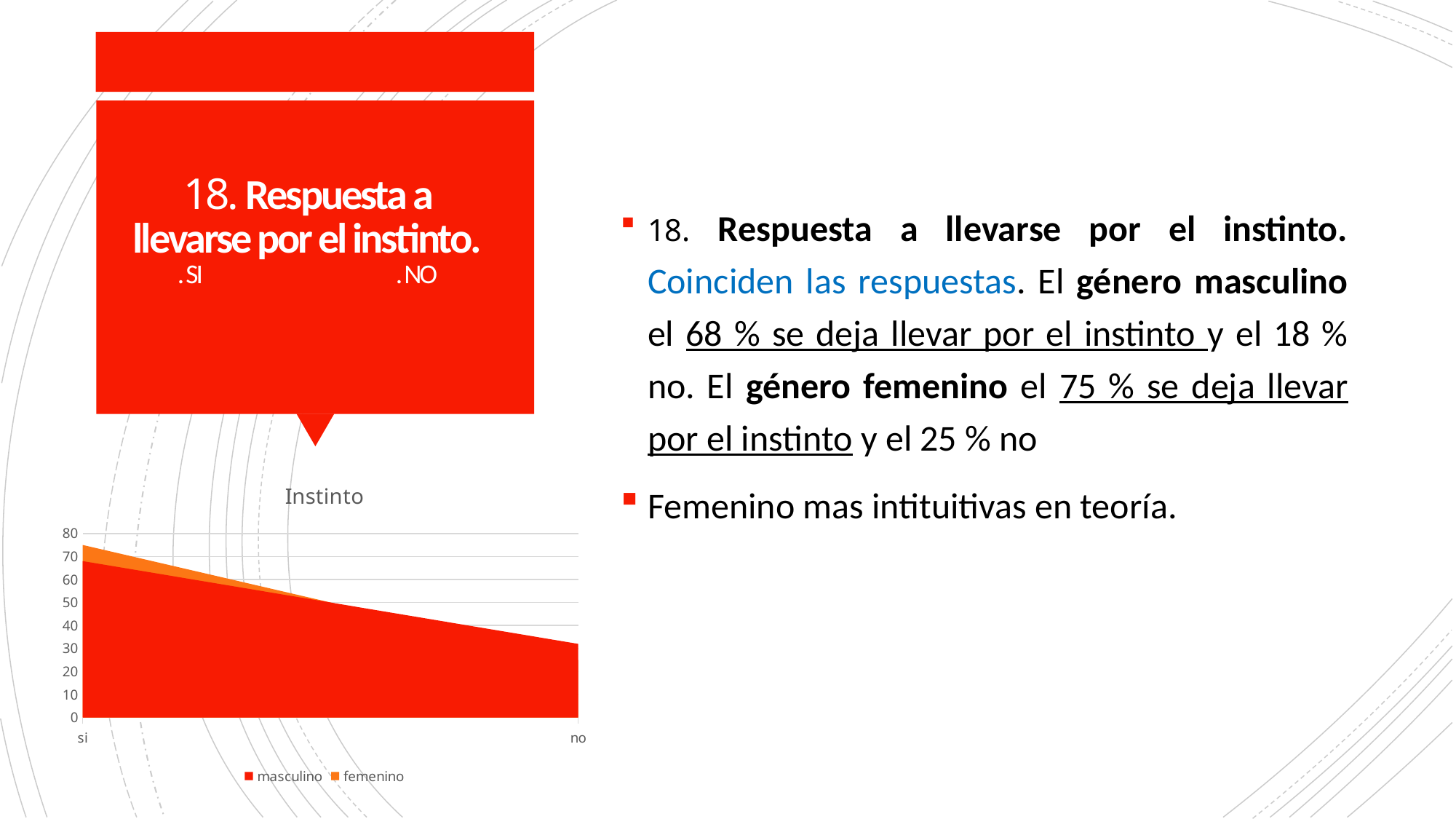
For the femenino series, which category has the lowest value? no Is the value for femenino at 'si' greater or less than 70? greater Is the value for masculino at 'si' greater or less than 60? greater For the masculino series, which category has the highest value? si Which series is shown in orange in the chart legend? femenino Do the values in the chart rise or fall from 'si' to 'no'? fall At 'si', which series has the higher value, masculino or femenino? femenino How many series does the chart legend list? 2 Is the value for masculino at 'no' greater or less than 40? less What is the title of the chart? Instinto How many categories are shown on the x axis of the chart? 2 What kind of chart is shown on the slide? area chart